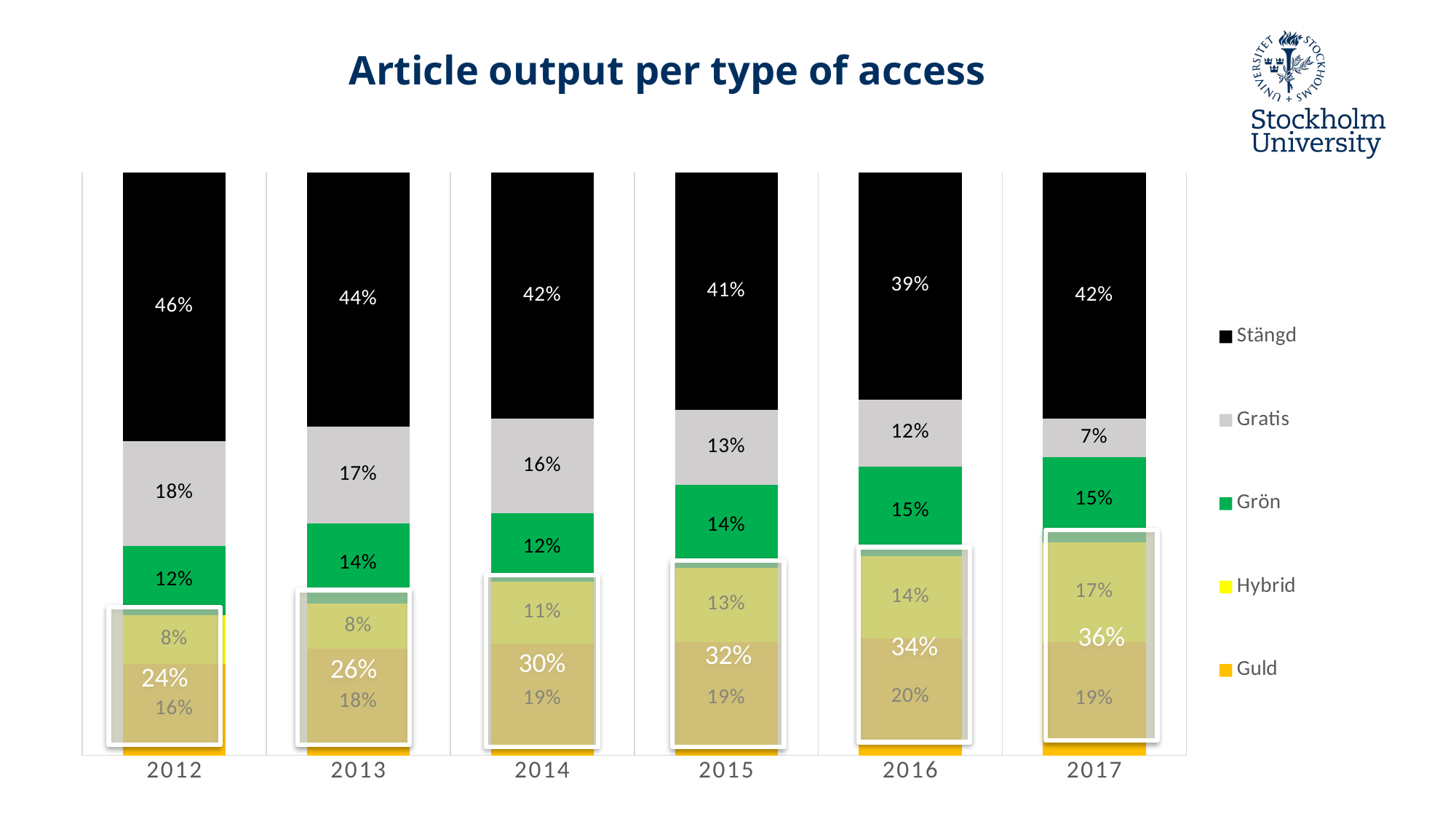
What is the title of the chart? Article output per type of access How many years are shown on the x axis? 6 In which year is the Gratis share highest? 2012 In which year is the Stängd share lowest? 2016 What is the difference between the Stängd share in 2012 and in 2016? 7% Is the Stängd share larger in 2013 or in 2015? 2013 How many series does the legend list? 5 Does the Gratis share rise or fall from 2012 to 2017? fall What is the Stängd share for 2012? 46% What type of chart is shown on the slide? stacked bar chart What is the Grön share for 2016? 15% What is the Gratis share for 2017? 7%